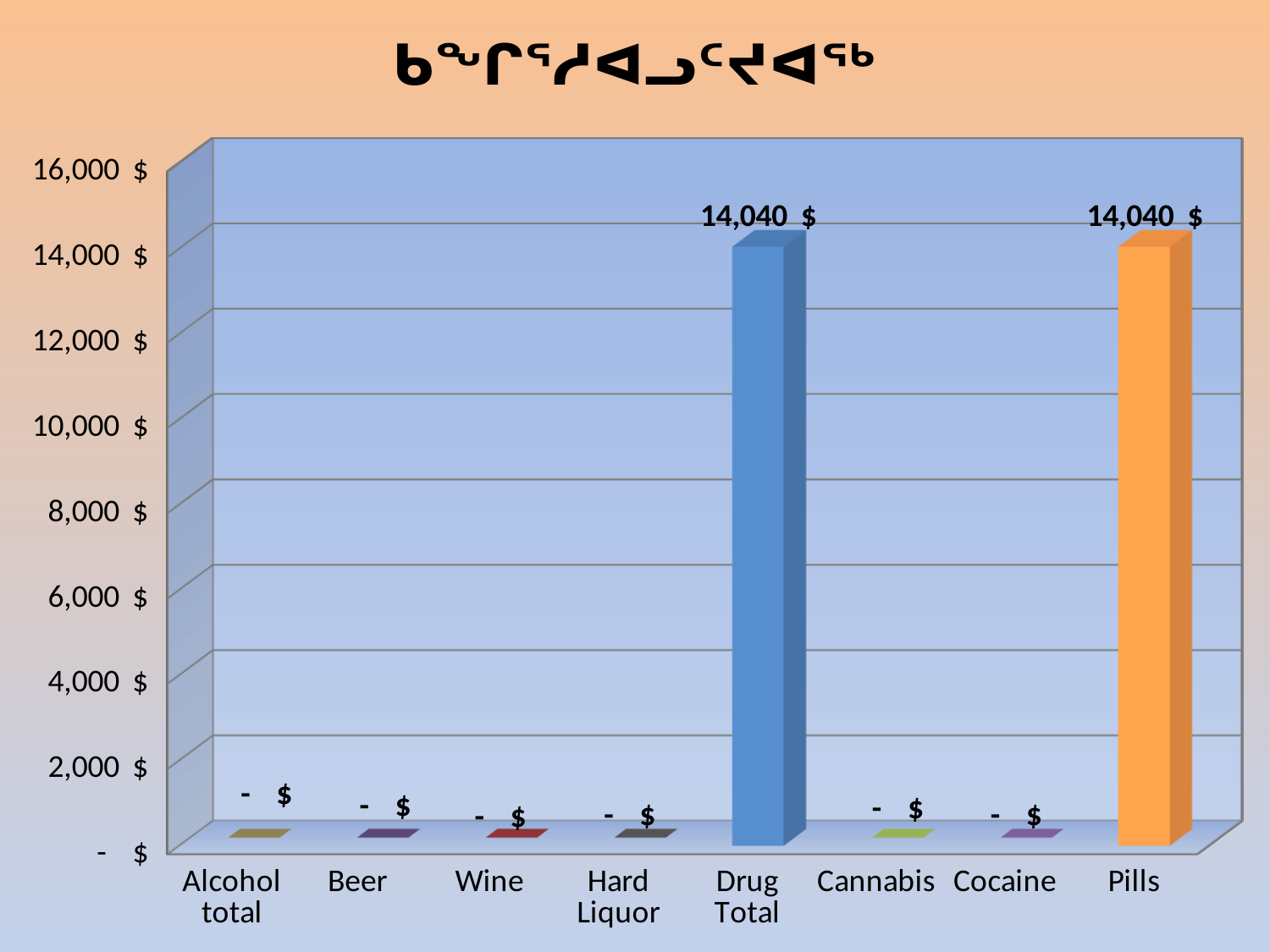
How many categories are shown on the x axis? 8 Is the value for Drug Total greater or less than 12,000 $? greater What is the value shown for Drug Total? 14,040 $ What colour is the bar for Drug Total? Blue What colour is the bar for Pills? Orange Which two categories share the highest value on the chart? Drug Total and Pills Which is larger, the value for Pills or the value for Cocaine? Pills What value is shown for Beer? - $ What is the difference between the values for Drug Total and Pills? 0 $ What is the value shown for Pills? 14,040 $ What kind of chart is shown on the slide? Bar chart Is the value for Pills greater or less than 16,000 $? less